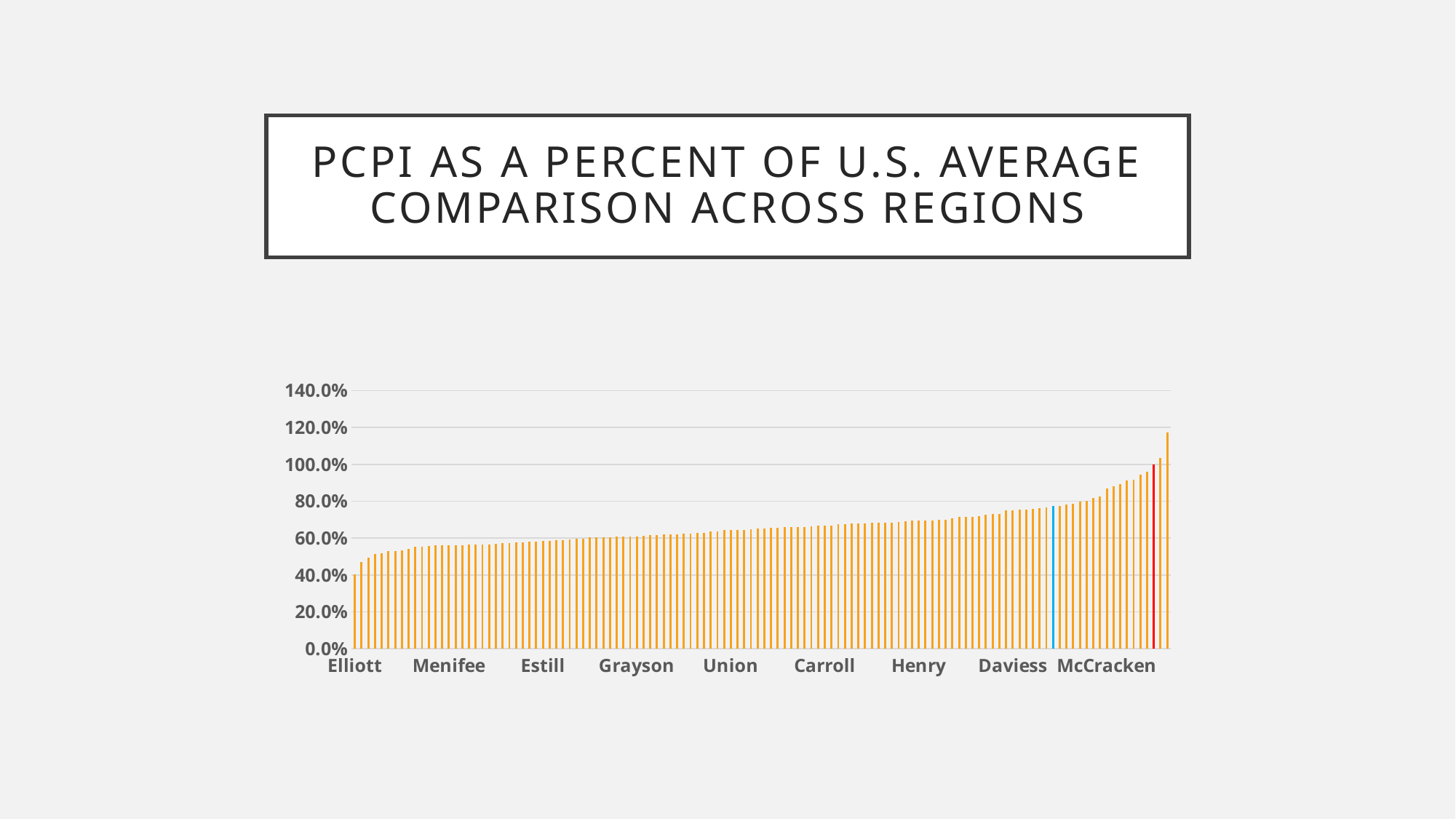
What is the title of the chart? PCPI as a Percent of U.S. Average Comparison Across Regions Is the value for Union greater or less than 60.0%? greater What colour are most of the bars in the chart? orange Is the value for Menifee greater or less than 60.0%? less Which has the larger value, Elliott or Daviess? Daviess Is the value for Carroll greater or less than 80.0%? less Do the values rise or fall moving from left to right along the x axis? rise Which labeled category has the lowest value? Elliott What kind of chart is shown on the slide? bar chart Which has the larger value, Menifee or Henry? Henry